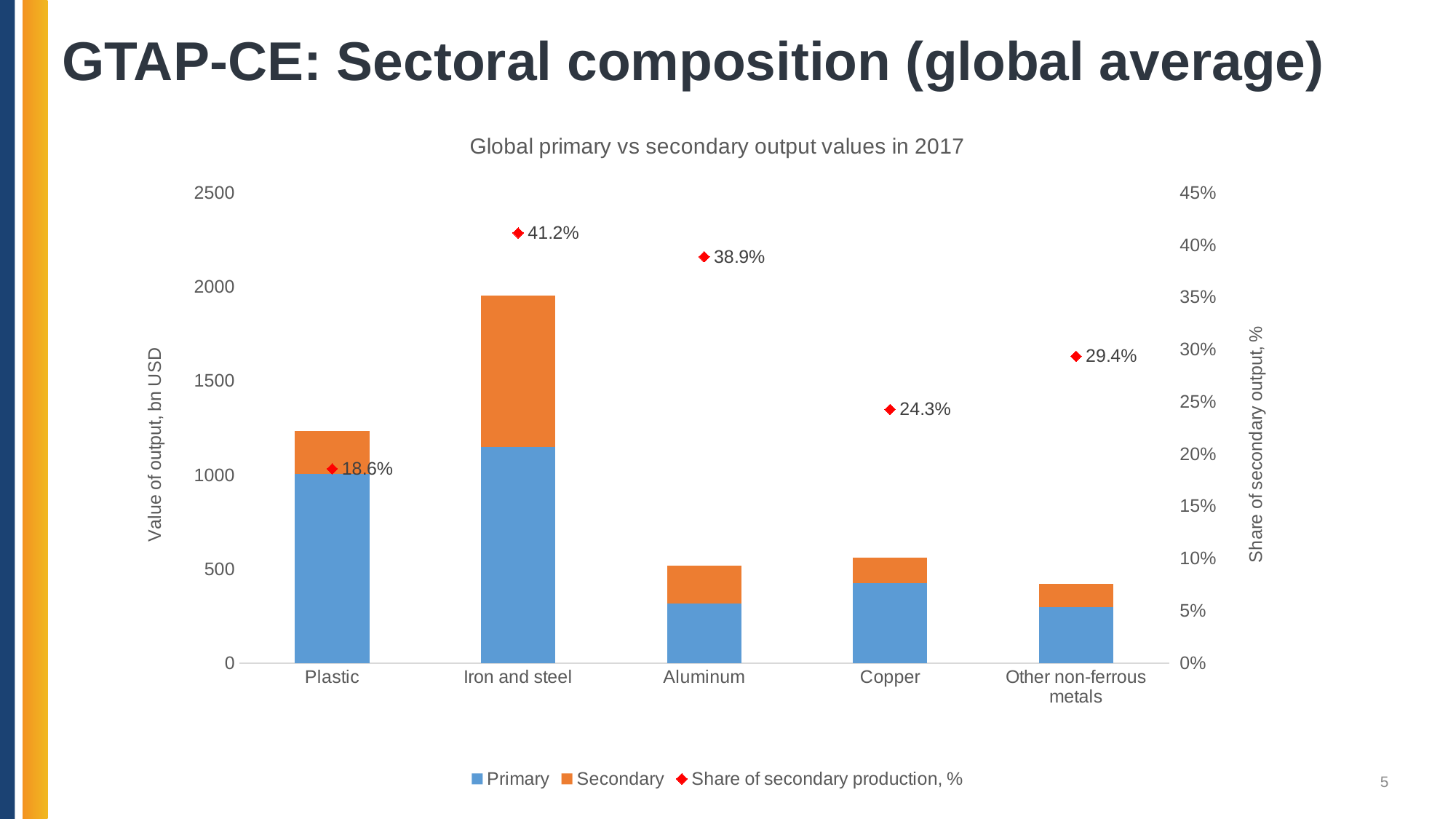
How much higher is the share of secondary production for Other non-ferrous metals than for Copper? 5.1 percentage points Is the total value of output for Aluminum greater or less than 1000 bn USD? less Which sector has the highest share of secondary production? Iron and steel Which sector has the tallest stacked bar for value of output? Iron and steel How much higher is the share of secondary production for Iron and steel than for Aluminum? 2.3 percentage points Which has a larger share of secondary production, Copper or Other non-ferrous metals? Other non-ferrous metals What is the share of secondary production for Copper? 24.3% How many series does the legend list? 3 Which sector has the lowest share of secondary production? Plastic Is the total value of output for Iron and steel greater or less than 1500 bn USD? greater What is the share of secondary production for Iron and steel? 41.2% What is the share of secondary production for Plastic? 18.6%